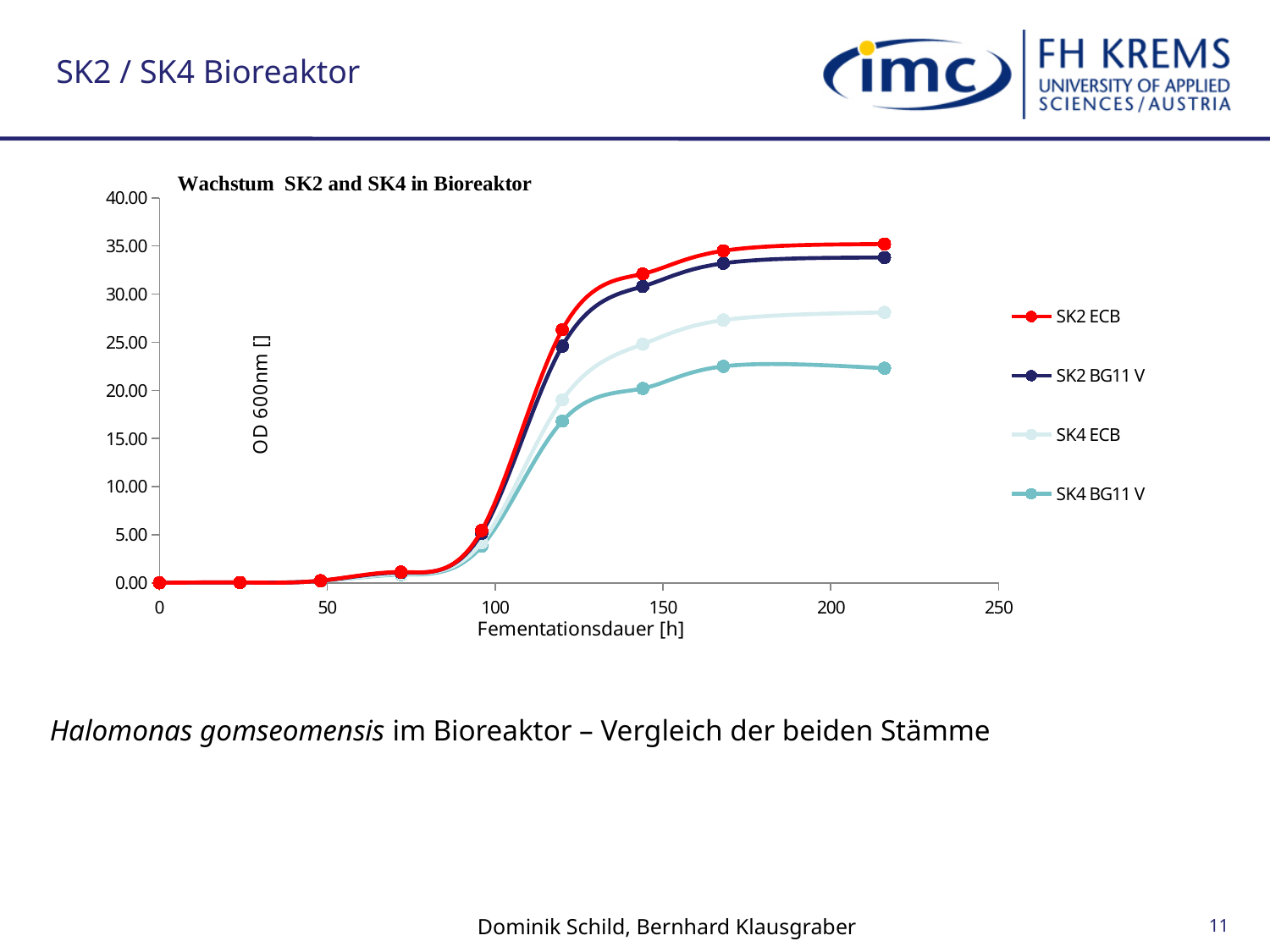
Is the final value for SK4 ECB greater or less than 25? greater How many data points are plotted for each series? 9 Which series has the lowest value at the end of the fermentation? SK4 BG11 V What is the title of the chart? Wachstum SK2 and SK4 in Bioreaktor Which series reaches the highest value at the end of the fermentation? SK2 ECB How many series does the legend list? 4 Is the final value for SK4 BG11 V greater or less than 25? less What is the label of the x axis? Fementationsdauer [h] Do the values of the series rise or fall as fermentation time increases? rise What kind of chart is shown on the slide? line chart At the last measured time point, which is larger: SK4 ECB or SK4 BG11 V? SK4 ECB Is the final value for SK2 ECB greater or less than 30? greater